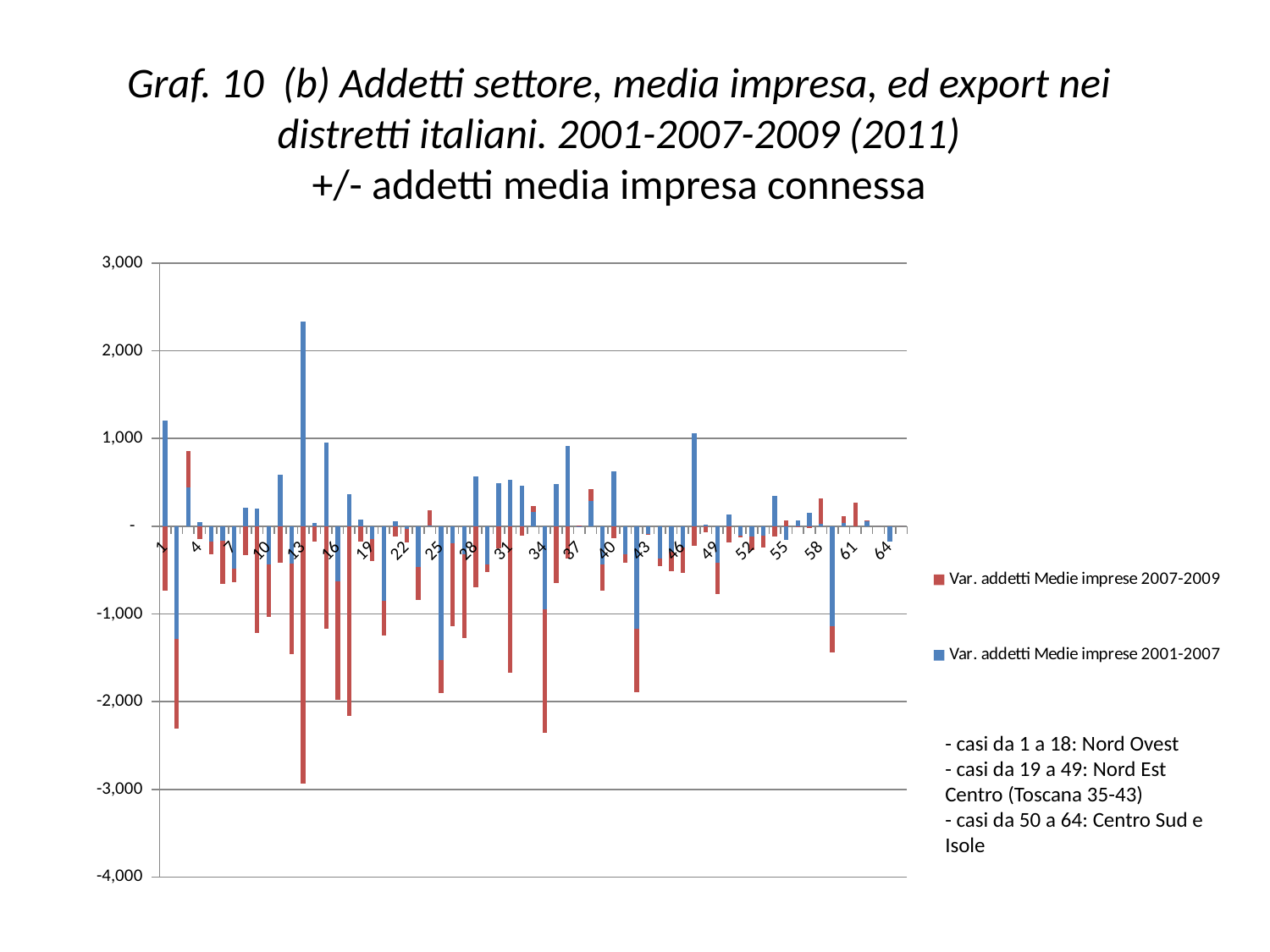
How many series does the legend list? 2 Which series is drawn in blue? Var. addetti Medie imprese 2001-2007 Which case has the lowest (most negative) bar in the chart? 13 Which case has the highest bar in the chart? 13 Is the 2007-2009 value for case 2 greater or less than -2,000? greater Is the 2007-2009 value for case 13 greater or less than -2,000? less Which series contains the highest bar in the chart, 2001-2007 or 2007-2009? 2001-2007 Which is larger, the 2001-2007 value for case 1 or the 2001-2007 value for case 13? case 13 Is the 2001-2007 value for case 13 greater or less than 2,000? greater What kind of chart is shown on the slide? bar chart What are the two series named in the legend? Var. addetti Medie imprese 2007-2009; Var. addetti Medie imprese 2001-2007